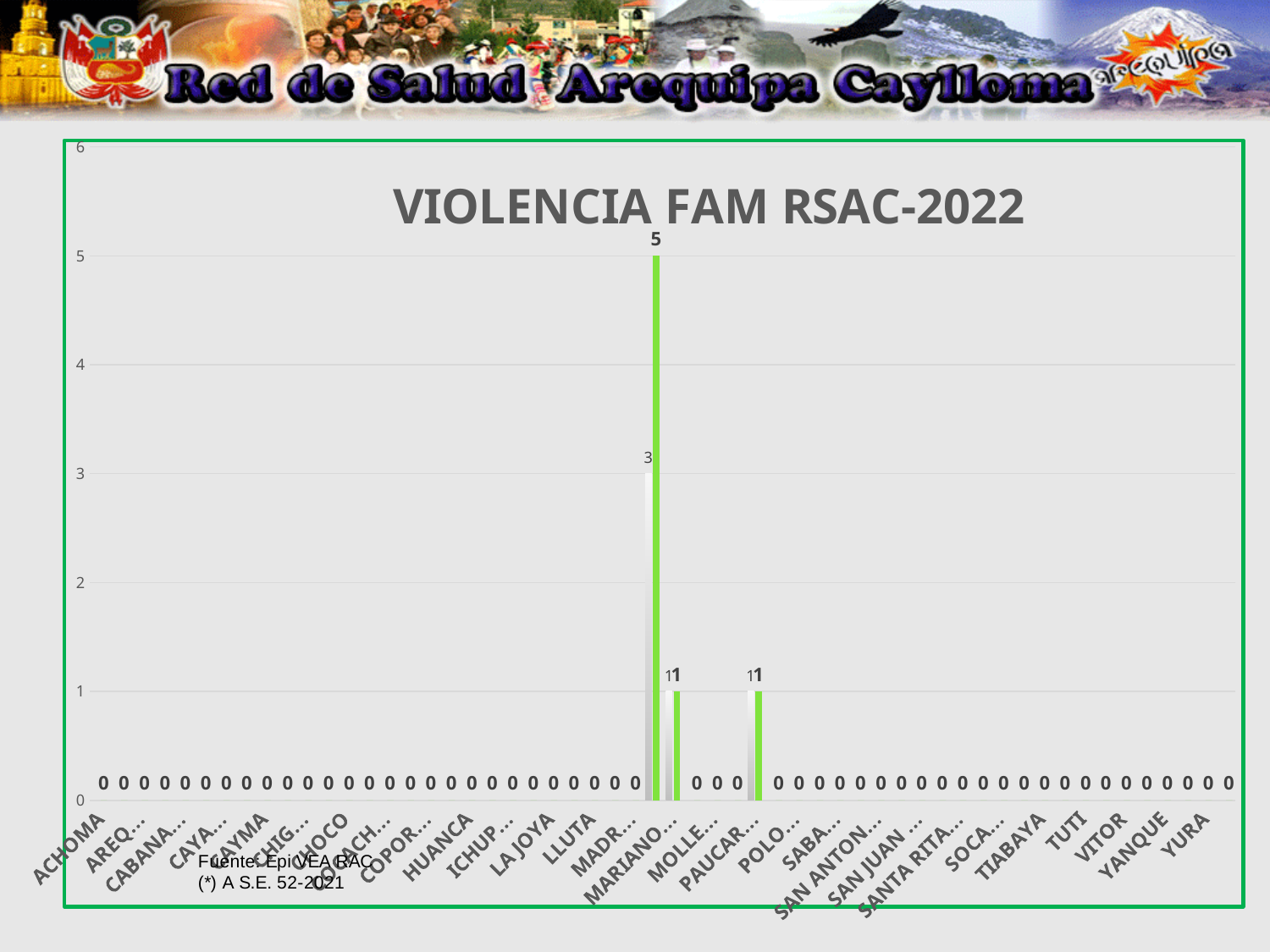
What source is cited below the chart? Epi VEA RAC What is the value shown for LA JOYA? 0 Is the tallest bar in the chart greater or less than 4? greater What is the value shown for ACHOMA? 0 What is the highest value labelled on any bar in the chart? 5 What is the difference between the two tallest bars in the chart, labelled 5 and 3? 2 Is the tallest grey bar in the chart greater or less than 4? less What is the value shown for YURA? 0 What kind of chart is shown on the slide? bar chart What is the value shown for HUANCA? 0 What is the value shown for TIABAYA? 0 What is the title of the chart? VIOLENCIA FAM RSAC-2022